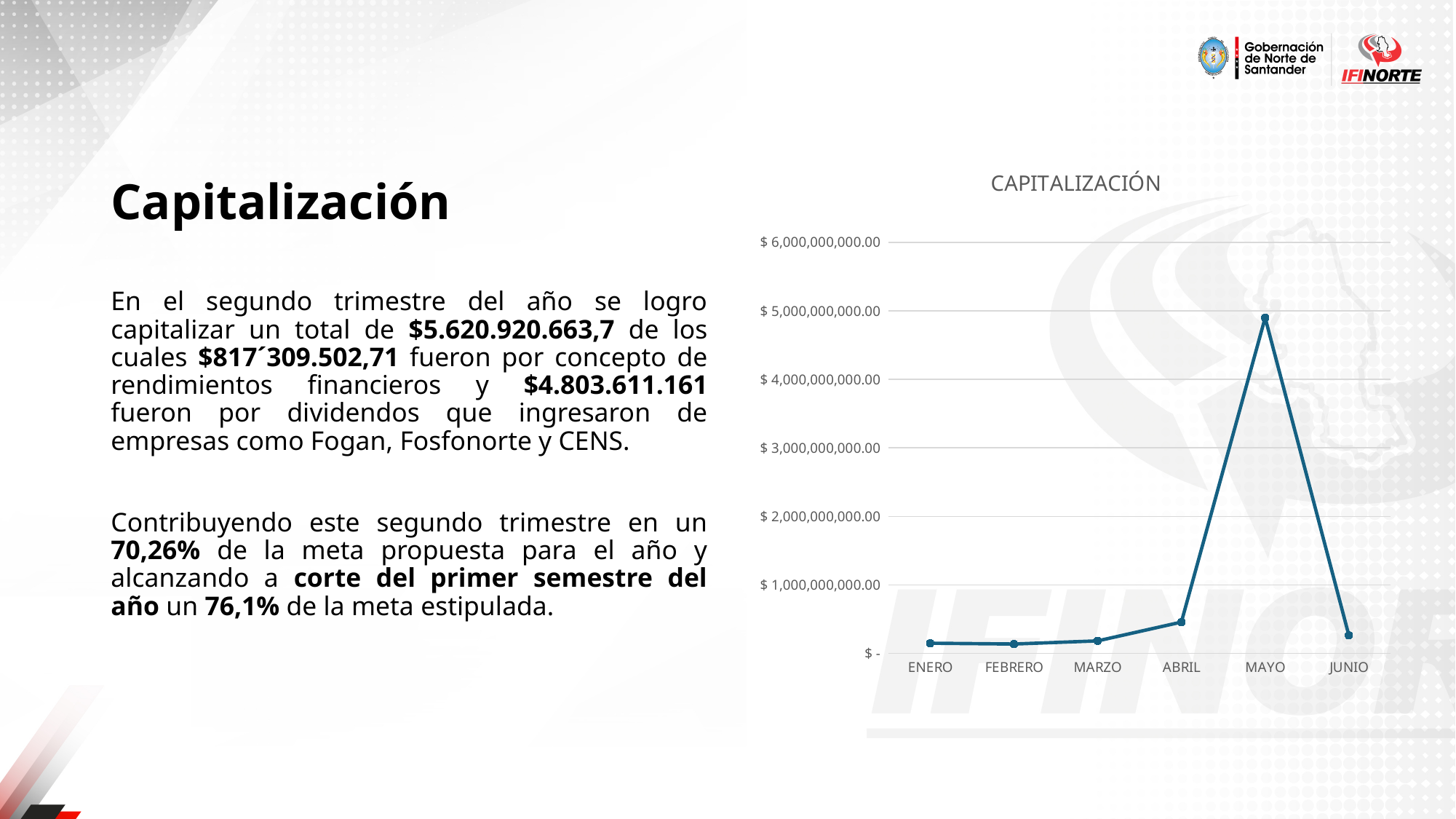
What is the title of the chart? CAPITALIZACIÓN Does the value rise or fall from MARZO to MAYO? rise Which is larger, the value for MAYO or the value for JUNIO? MAYO Which is larger, the value for ABRIL or the value for MARZO? ABRIL What is the first month shown on the x axis of the chart? ENERO Is the value for ABRIL greater or less than $ 1,000,000,000.00? less Does the value rise or fall from MAYO to JUNIO? fall How many months are plotted on the x axis of the chart? 6 Which month has the highest value in the chart? MAYO Is the value for JUNIO greater or less than $ 1,000,000,000.00? less Is the value for MAYO greater or less than $ 4,000,000,000.00? greater What kind of chart is shown on the slide? line chart